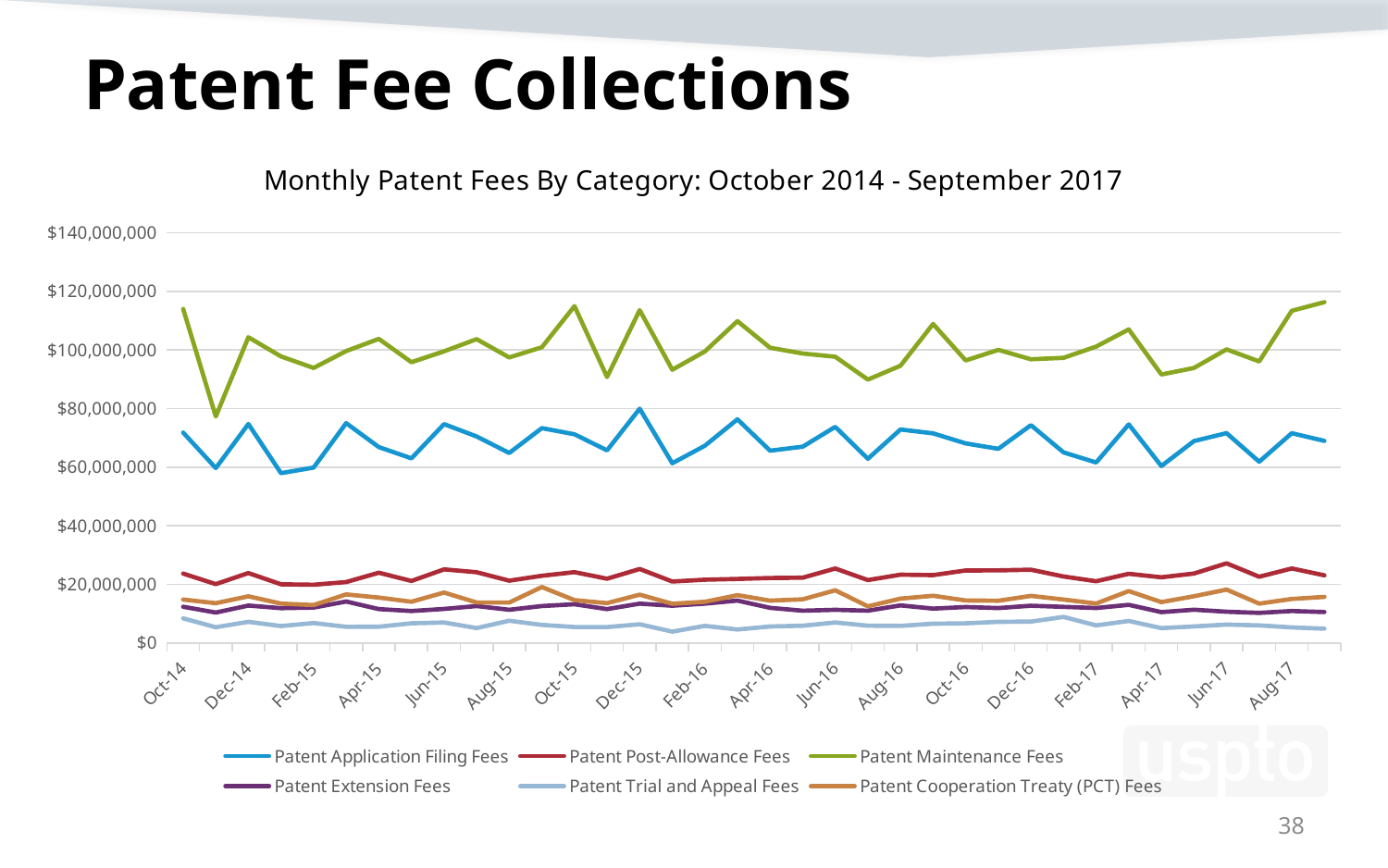
In Oct-14, which is larger: Patent Maintenance Fees or Patent Application Filing Fees? Patent Maintenance Fees Is the value for Patent Post-Allowance Fees in Jun-17 greater or less than $20,000,000? greater Does the Patent Application Filing Fees line rise or fall from Oct-14 to Nov-14? fall Is the value for Patent Trial and Appeal Fees in Aug-17 greater or less than $20,000,000? less What kind of chart is shown on the slide? line chart Is the value for Patent Maintenance Fees in Oct-14 greater or less than $100,000,000? greater How many series does the legend list? 6 Which series has the lowest values throughout the chart? Patent Trial and Appeal Fees What is the title of the chart? Monthly Patent Fees By Category: October 2014 - September 2017 What colour is the Patent Maintenance Fees line? green Which series has the highest values throughout the chart? Patent Maintenance Fees